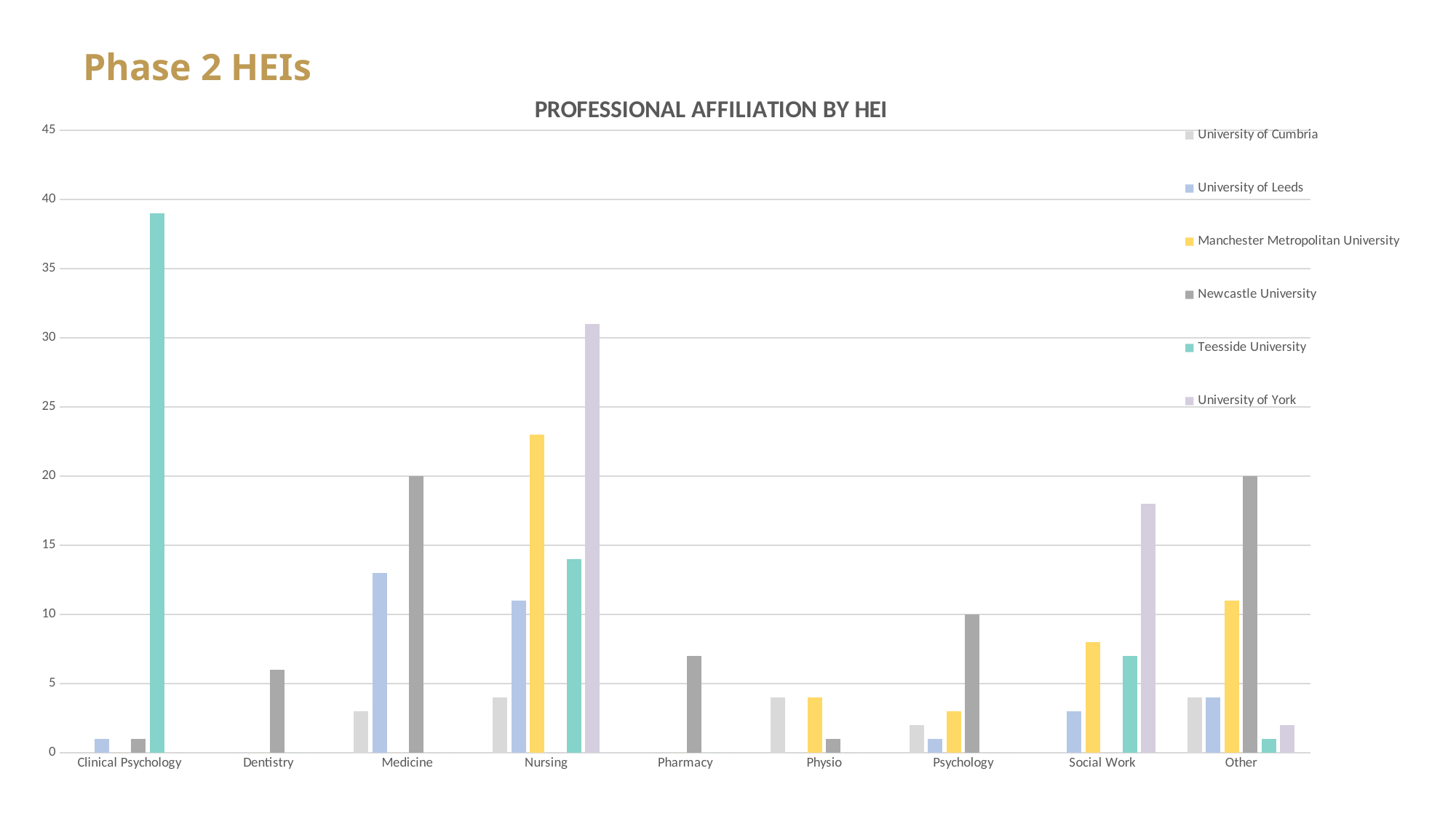
What is the value for Newcastle University in the Medicine category? 20 Is the value for Teesside University in Clinical Psychology greater or less than 35? greater How many series does the legend list? 6 Which university has the highest value in the Nursing category? University of York Which university has the tallest bar in the whole chart, and in which category? Teesside University, Clinical Psychology Is the value for University of York in Social Work greater or less than 15? greater What is the difference between Newcastle University's value in Medicine and its value in Psychology? 10 What is the value for Newcastle University in the Other category? 20 How many professional affiliation categories are shown on the x axis? 9 In the Nursing category, which is larger: University of York or Manchester Metropolitan University? University of York What type of chart is shown on the slide? bar chart What is the value for Newcastle University in the Psychology category? 10